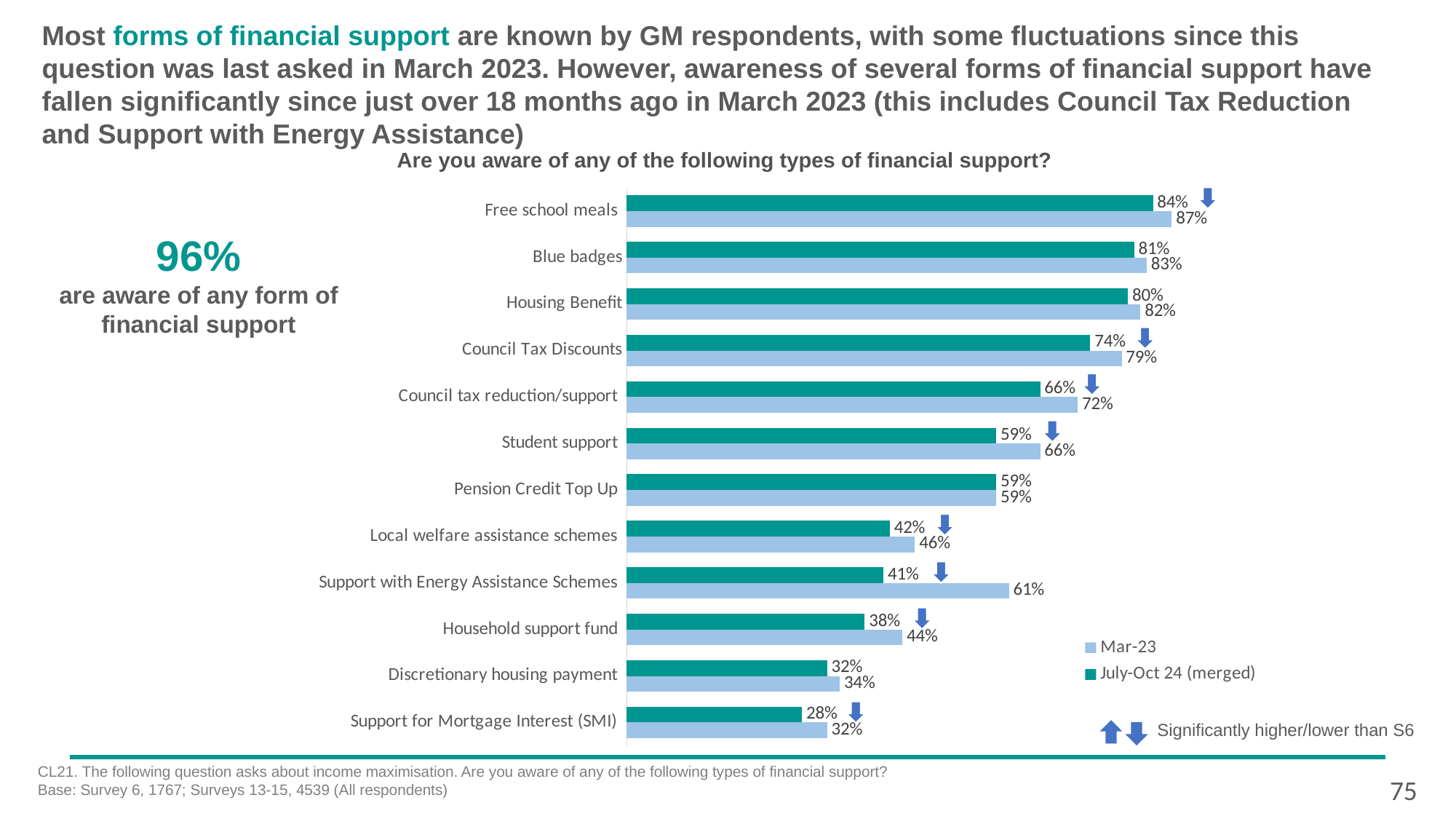
Which is larger for Student support: the Mar-23 value or the July-Oct 24 (merged) value? Mar-23 What is the difference between the Mar-23 and July-Oct 24 (merged) values for Council tax reduction/support? 6 percentage points What is the title of the chart? Are you aware of any of the following types of financial support? What is the July-Oct 24 (merged) value for Free school meals? 84% What kind of chart is shown on the slide? Bar chart What is the Mar-23 value for Support with Energy Assistance Schemes? 61% What is the difference between the Mar-23 and July-Oct 24 (merged) values for Support with Energy Assistance Schemes? 20 percentage points How many categories are shown in the chart? 12 Which category has the lowest Mar-23 value? Support for Mortgage Interest (SMI) What is the July-Oct 24 (merged) value for Household support fund? 38% How many series does the legend list? 2 Which category has the highest July-Oct 24 (merged) value? Free school meals